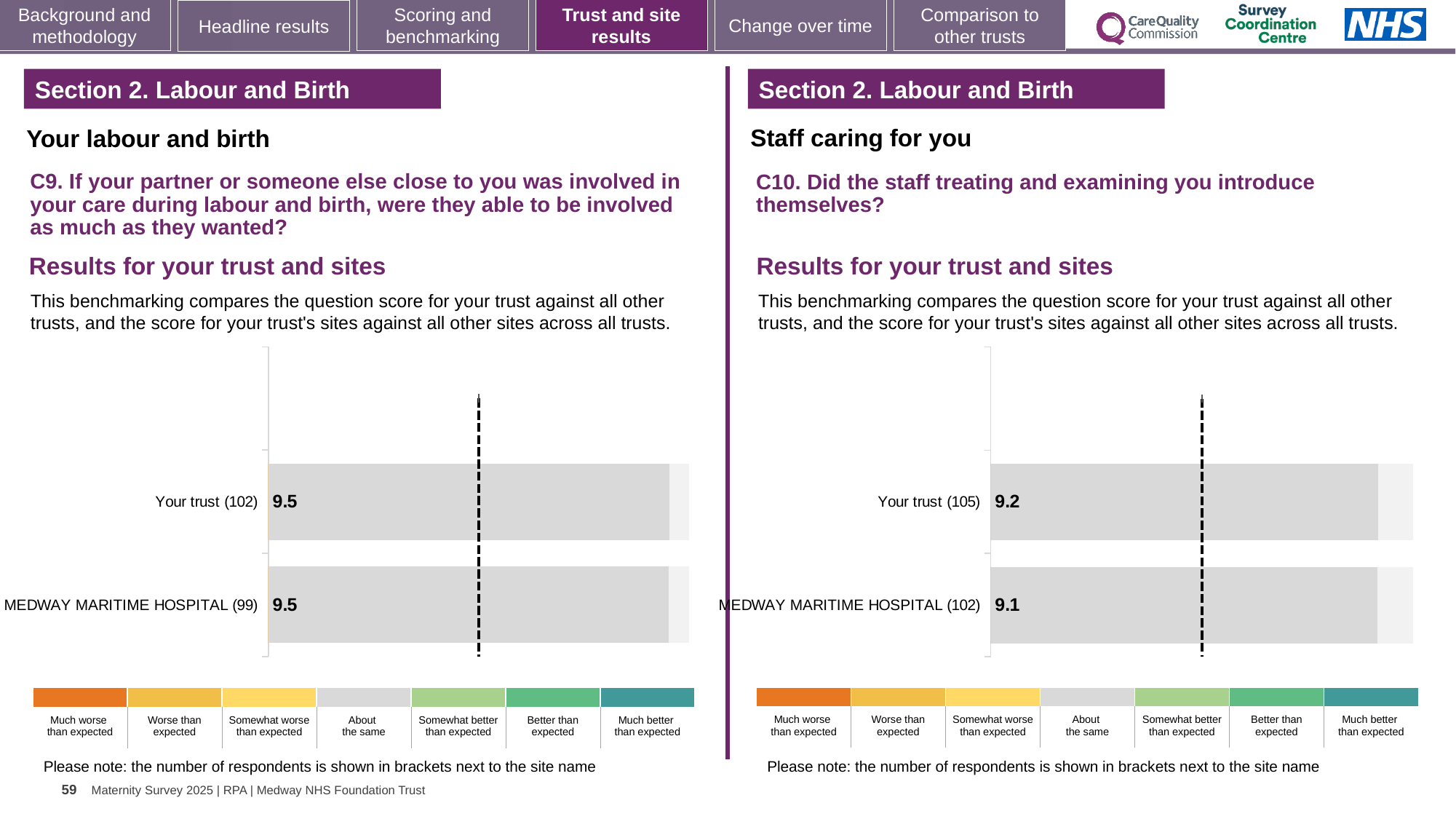
In the C10 chart on the right, how many respondents are shown in brackets for Your trust? 105 In the C9 chart on the left, what is the difference between the score for Your trust and the score for MEDWAY MARITIME HOSPITAL? 0 In the C10 chart on the right, which has the higher score, Your trust or MEDWAY MARITIME HOSPITAL? Your trust How many bars are plotted in the C10 chart on the right? 2 In the C10 chart on the right, what is the score for MEDWAY MARITIME HOSPITAL? 9.1 In the C9 chart on the left, what is the score for Your trust? 9.5 In the C9 chart on the left, how many respondents are shown in brackets for MEDWAY MARITIME HOSPITAL? 99 What kind of chart is used for the C9 results on the left? Bar chart In the C10 chart on the right, what is the difference between the score for Your trust and the score for MEDWAY MARITIME HOSPITAL? 0.1 How many bars are plotted in the C9 chart on the left? 2 In the C10 chart on the right, what is the score for Your trust? 9.2 In the C9 chart on the left, what is the score for MEDWAY MARITIME HOSPITAL? 9.5